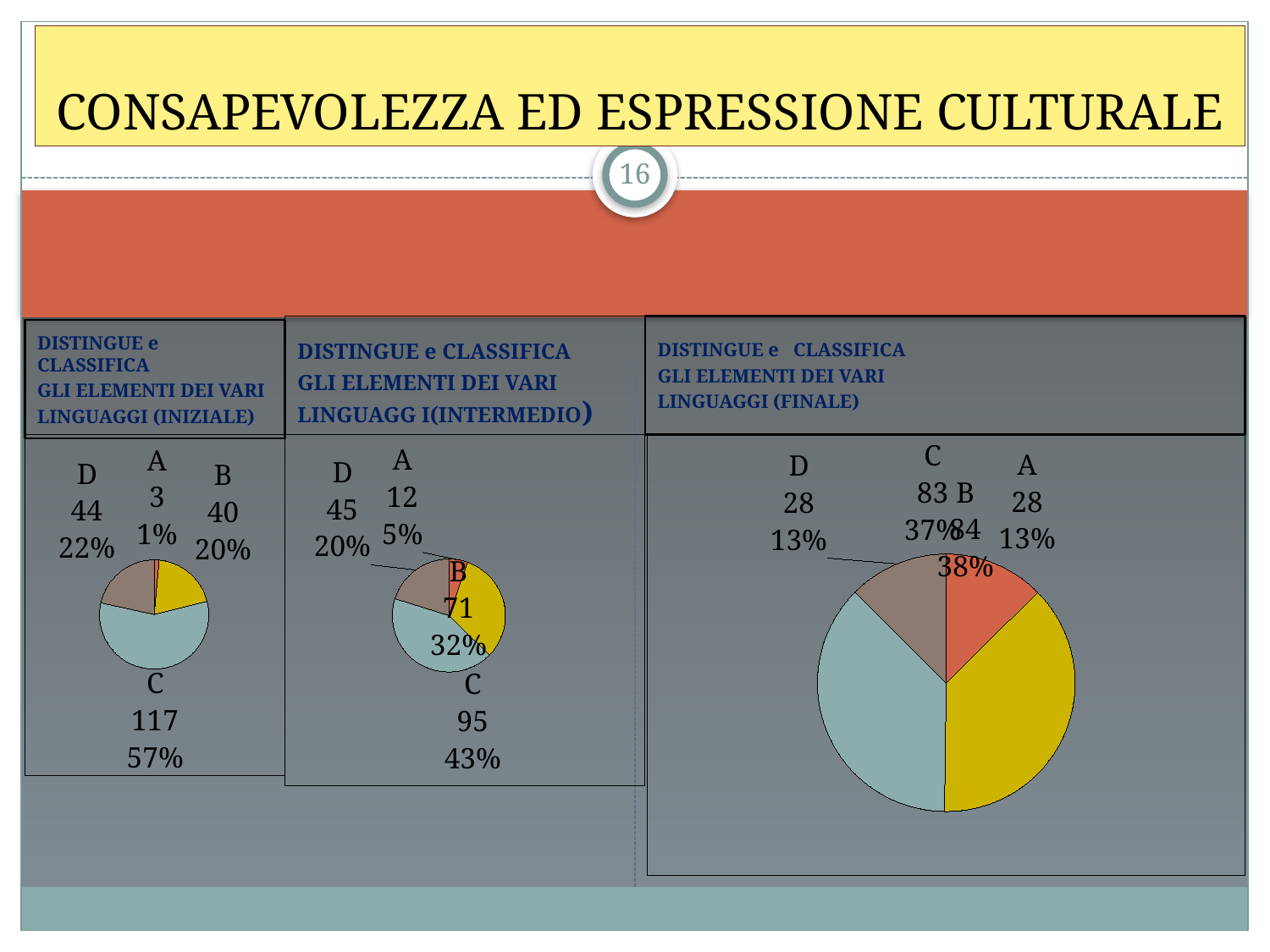
In the INIZIALE chart (left), what is the difference between the values for C and B? 77 In the INTERMEDIO chart (middle), what percentage is shown for category A? 5% In the INIZIALE chart (left), what percentage is shown for category D? 22% In the INTERMEDIO chart (middle), what value is shown for category B? 71 What kind of chart is used in the FINALE panel (right)? Pie chart In the INIZIALE chart (left), which category has the smallest share? A In the FINALE chart (right), what percentage is shown for category D? 13% In the FINALE chart (right), what value is shown for category A? 28 In the INTERMEDIO chart (middle), which is larger, the value for D or the value for A? D In the INTERMEDIO chart (middle), which category has the largest share? C In the INIZIALE chart (left), what value is shown for category C? 117 How many categories does the INIZIALE chart (left) show? 4